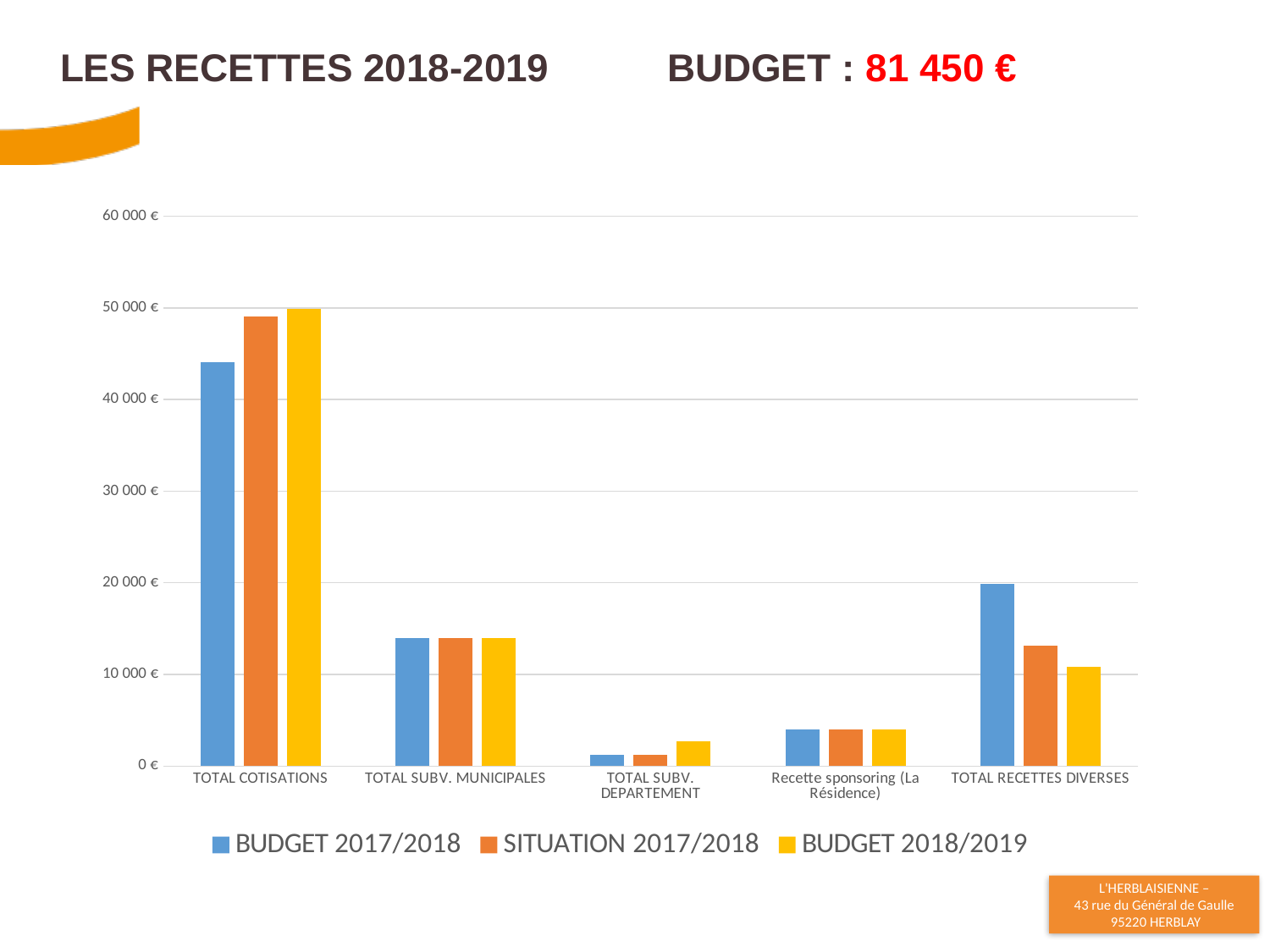
Is the BUDGET 2017/2018 value for TOTAL COTISATIONS greater or less than 40 000 €? greater For TOTAL COTISATIONS, which is larger: BUDGET 2017/2018 or SITUATION 2017/2018? SITUATION 2017/2018 Which category has the lowest BUDGET 2017/2018 value? TOTAL SUBV. DEPARTEMENT Is the SITUATION 2017/2018 value for TOTAL SUBV. MUNICIPALES greater or less than 10 000 €? greater For TOTAL RECETTES DIVERSES, which is larger: BUDGET 2017/2018 or BUDGET 2018/2019? BUDGET 2017/2018 Which category has the highest BUDGET 2018/2019 value? TOTAL COTISATIONS What are the three series listed in the legend? BUDGET 2017/2018, SITUATION 2017/2018, BUDGET 2018/2019 What kind of chart is shown on the slide? Bar chart What colour represents the BUDGET 2018/2019 series? Yellow How many series does the legend list? 3 How many categories are shown on the x axis? 5 Is the BUDGET 2018/2019 value for TOTAL RECETTES DIVERSES greater or less than 20 000 €? less